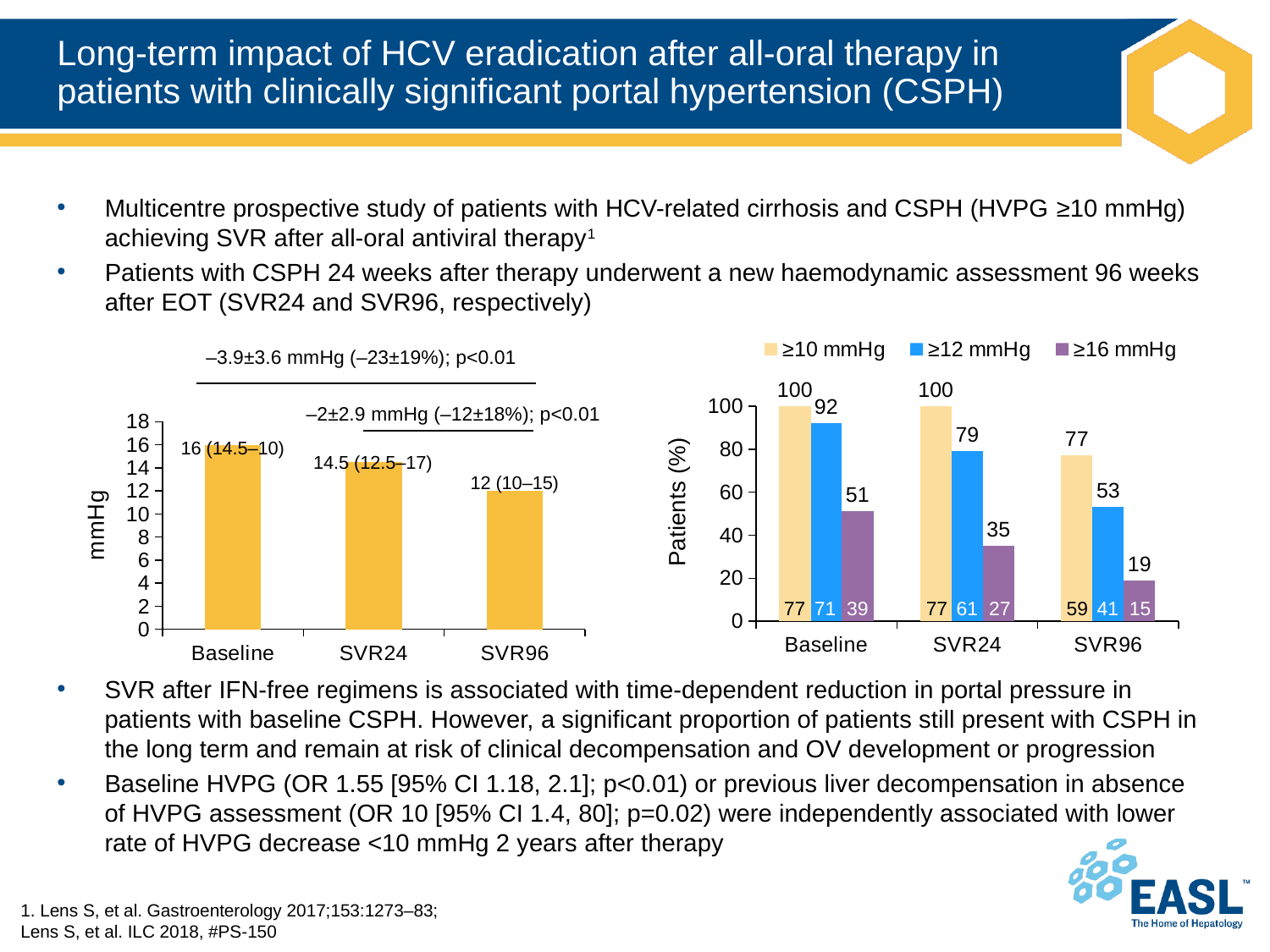
In the left chart (mmHg), what is the value for Baseline? 16 In the left chart (mmHg), which category has the lowest value? SVR96 In the right chart (Patients %), how many series does the legend list? 3 In the right chart (Patients %), what is the value for ≥16 mmHg at SVR96? 19 What kind of chart is the right chart (Patients %)? bar chart In the left chart (mmHg), what is the value for SVR96? 12 In the left chart (mmHg), how many categories are shown on the x axis? 3 In the right chart (Patients %), what is the difference between the ≥10 mmHg values at SVR24 and SVR96? 23 In the left chart (mmHg), what is the difference between the Baseline and SVR96 values? 4 In the right chart (Patients %), which is larger at Baseline: ≥12 mmHg or ≥16 mmHg? ≥12 mmHg In the left chart (mmHg), do the values rise or fall from Baseline to SVR96? fall In the right chart (Patients %), what is the value for ≥12 mmHg at SVR24? 79